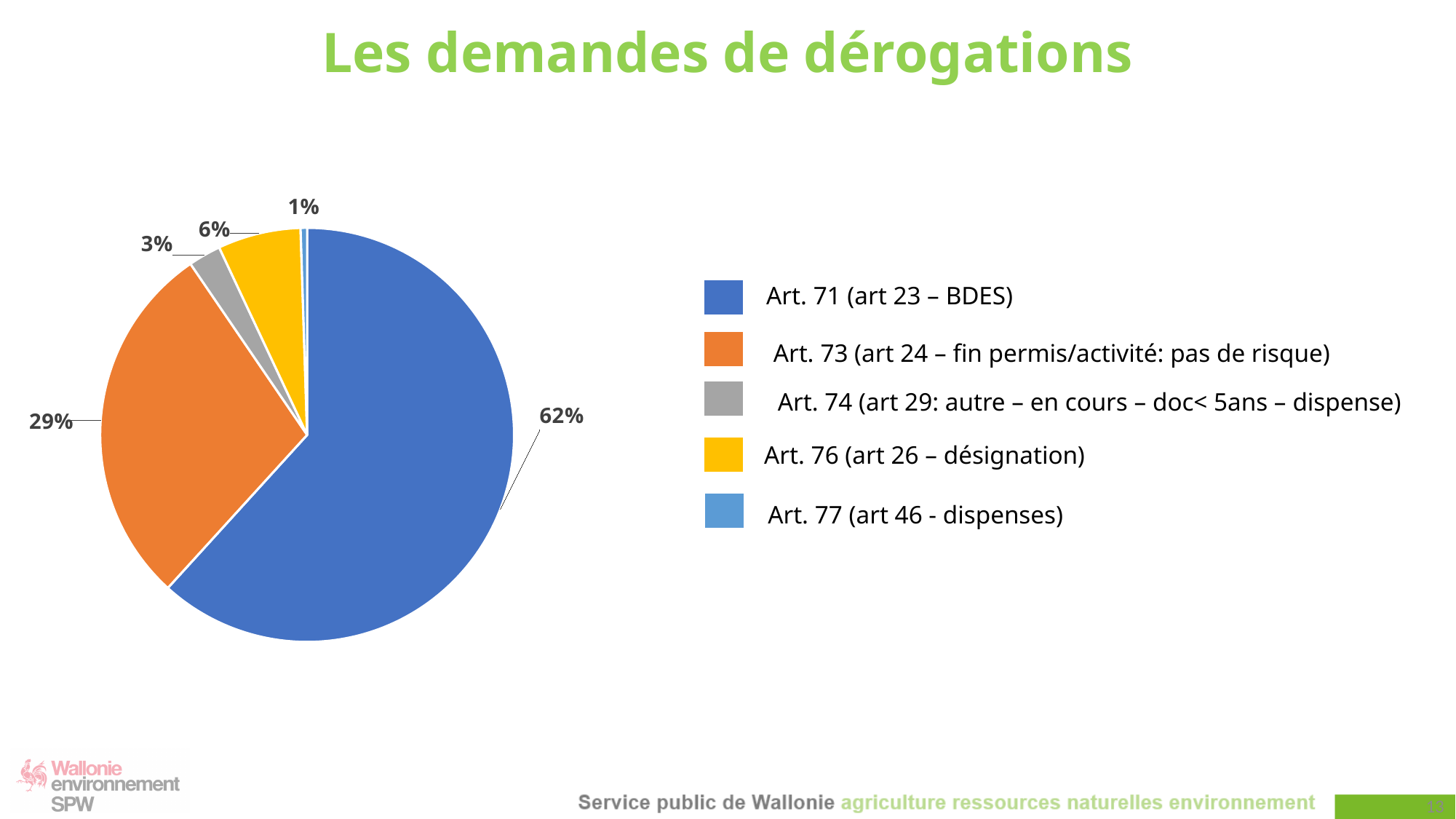
Which is larger, the Art. 76 slice or the Art. 74 slice? Art. 76 (art 26 – désignation) What kind of chart is shown on the slide? pie chart What share of the pie does Art. 77 (art 46 - dispenses) represent? 1% What share of the pie does Art. 76 (art 26 – désignation) represent? 6% What share of the pie does Art. 71 (art 23 – BDES) represent? 62% Which category has the smallest slice of the pie? Art. 77 (art 46 - dispenses) Which category has the largest slice of the pie? Art. 71 (art 23 – BDES) What is the difference in percentage points between the Art. 71 slice and the Art. 73 slice? 33 What is the title of the slide containing the pie chart? Les demandes de dérogations How many categories does the legend list? 5